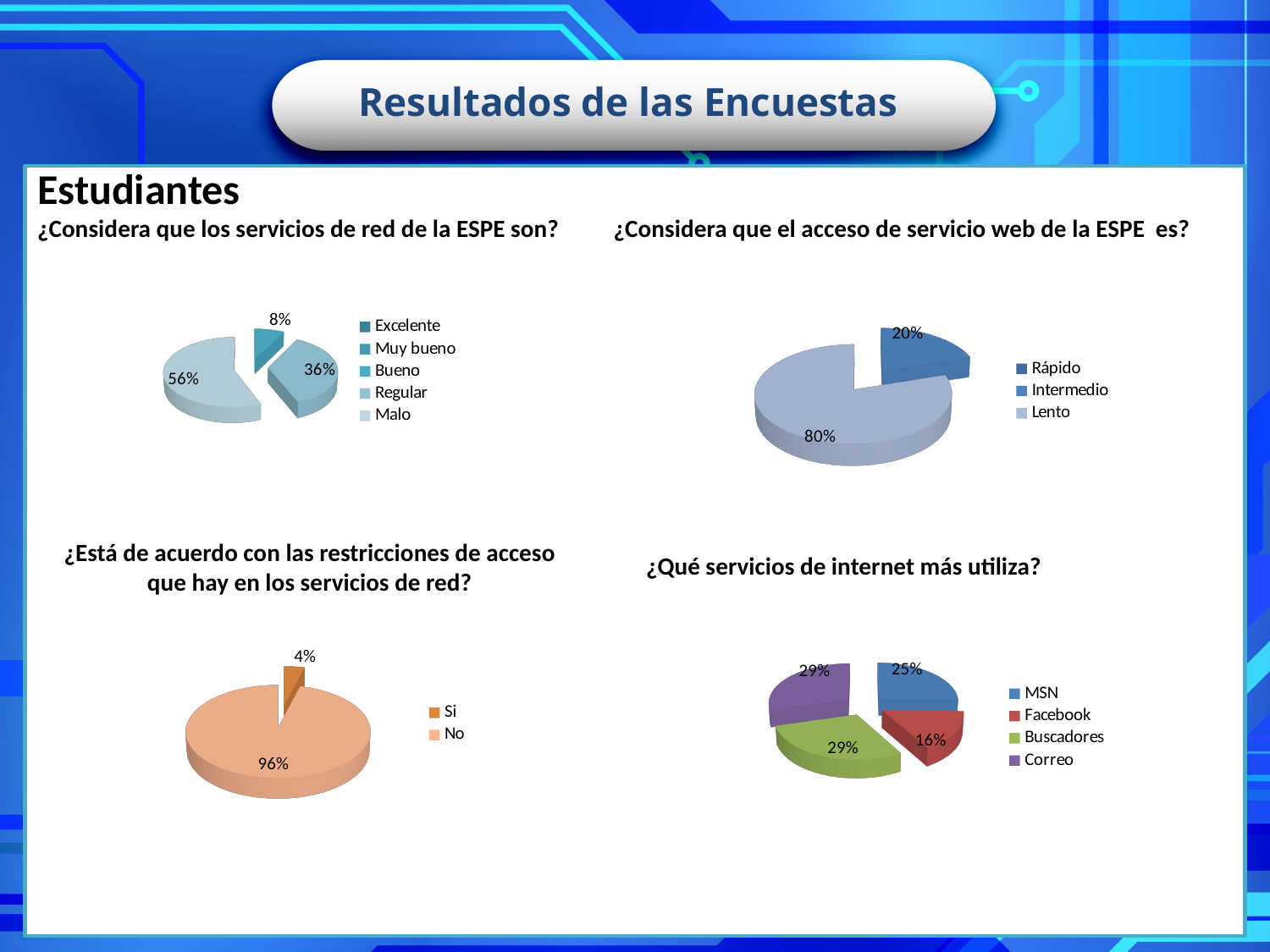
In the chart '¿Está de acuerdo con las restricciones de acceso que hay en los servicios de red?', what percentage answered 'No'? 96% In the chart '¿Considera que el acceso de servicio web de la ESPE es?', what is the largest percentage shown? 80% In the chart '¿Considera que el acceso de servicio web de la ESPE es?', what percentage corresponds to 'Lento'? 80% In the chart '¿Qué servicios de internet más utiliza?', which service has the smallest share? Facebook In the chart '¿Qué servicios de internet más utiliza?', how many categories does the legend list? 4 In the chart '¿Qué servicios de internet más utiliza?', what is the share for MSN? 25% What type of chart is used for '¿Está de acuerdo con las restricciones de acceso que hay en los servicios de red?'? Pie chart In the chart '¿Qué servicios de internet más utiliza?', what is the share for Buscadores? 29% In the chart '¿Considera que los servicios de red de la ESPE son?', what is the largest percentage shown? 56% In the chart '¿Qué servicios de internet más utiliza?', what is the share for Facebook? 16% In the chart '¿Qué servicios de internet más utiliza?', what is the difference between the MSN share and the Facebook share? 9% In the chart '¿Está de acuerdo con las restricciones de acceso que hay en los servicios de red?', what percentage answered 'Si'? 4%